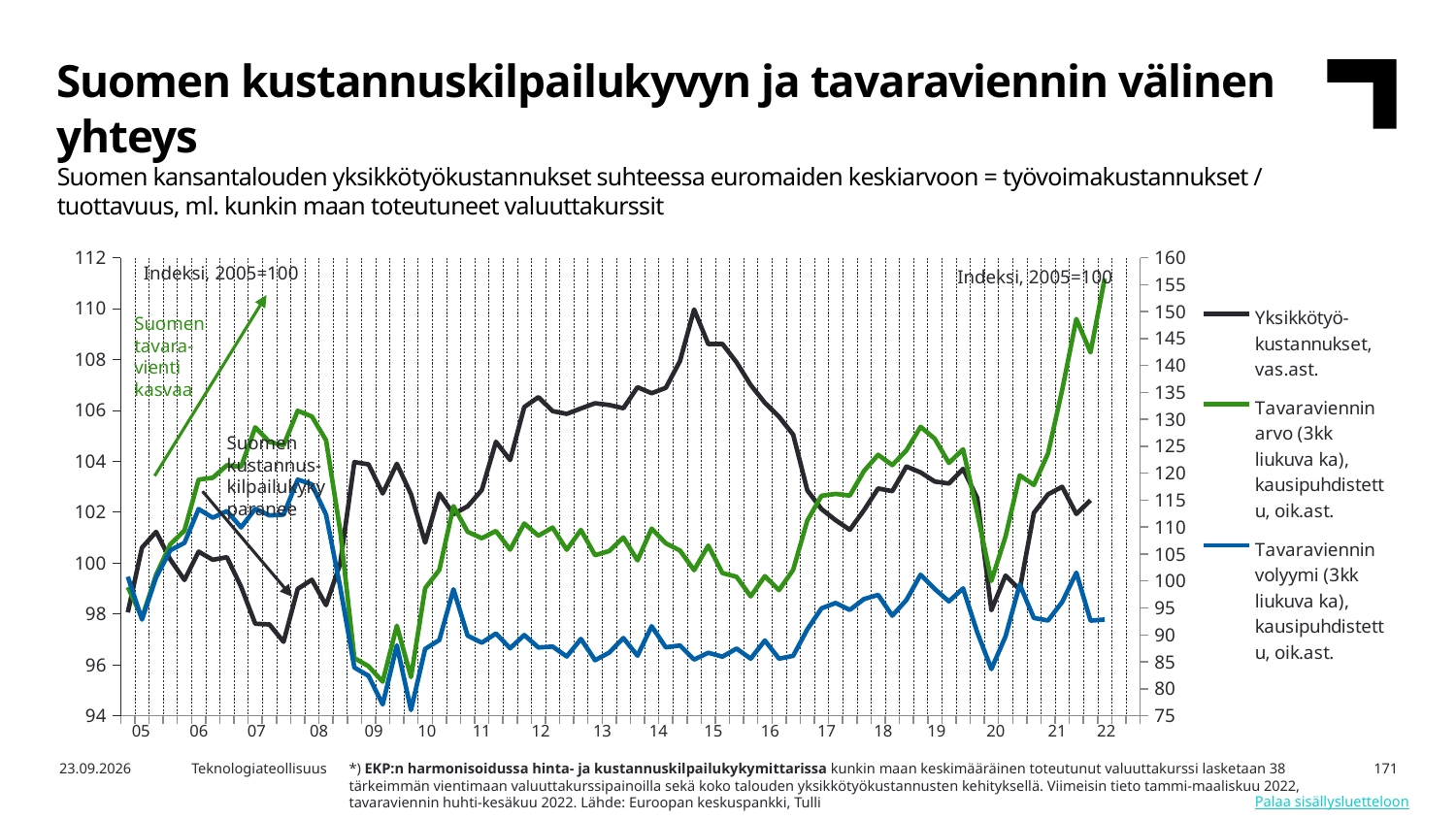
Is the value of Yksikkötyökustannukset at its low point in 2020 greater or less than 100? less Which series is plotted on the left axis (vas.ast.)? Yksikkötyökustannukset Is the value of Tavaraviennin arvo at the end of the series in 2022 greater or less than 150? greater Is the value of Tavaraviennin volyymi at its low point in 2009 greater or less than 85? less How many series does the legend list? 3 Does the Tavaraviennin arvo line rise or fall between 2020 and 2022? rise What kind of chart is shown on the slide? line chart How many year labels are shown on the x axis? 18 At the end of the series in 2022, which is higher on the right axis: Tavaraviennin arvo or Tavaraviennin volyymi? Tavaraviennin arvo What colour is the line for Tavaraviennin volyymi? blue